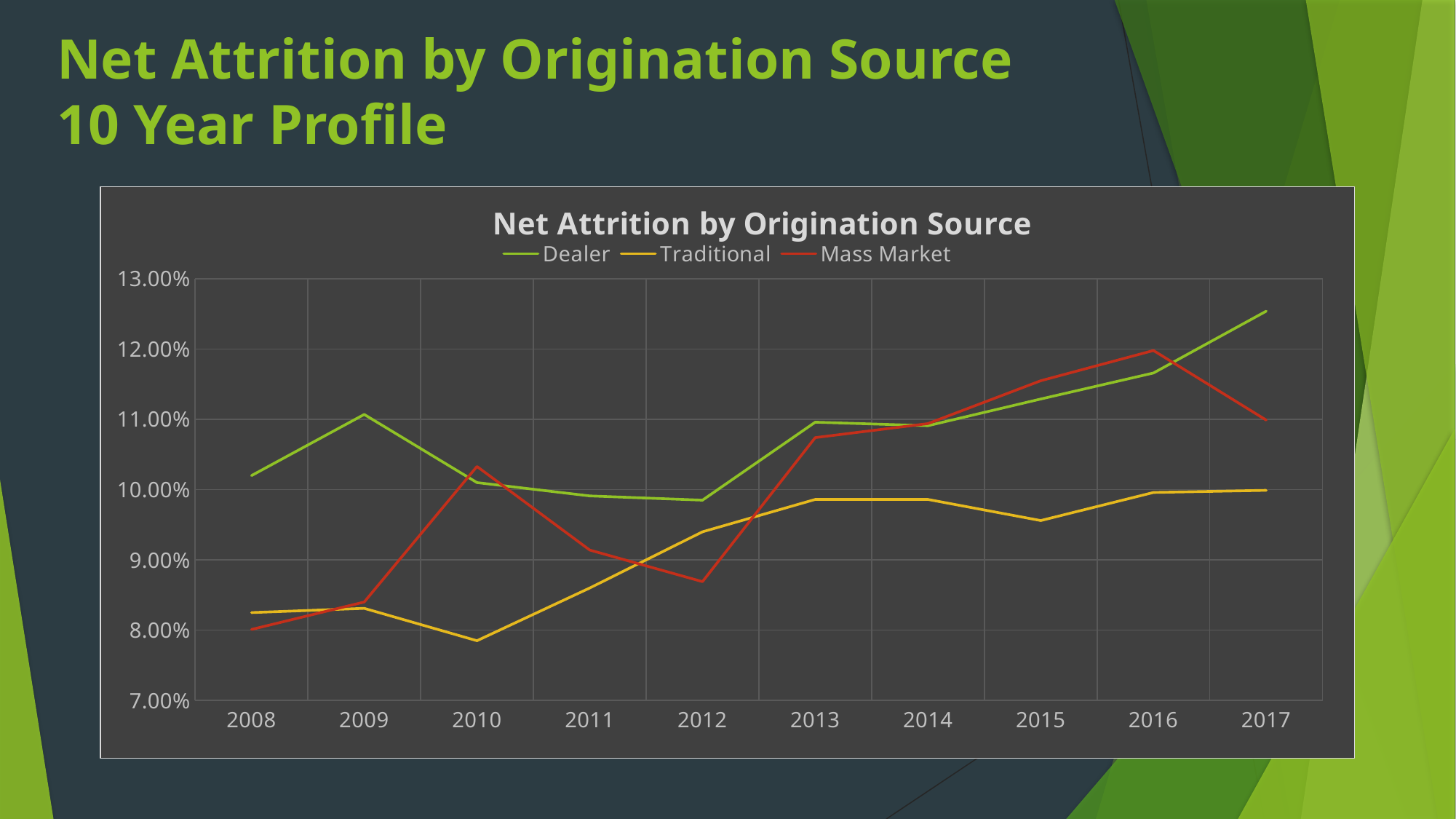
How many years are plotted along the x axis? 10 What kind of chart is shown on the slide? line chart In 2017, which series has the higher value, Dealer or Mass Market? Dealer Is the Dealer value for 2017 greater or less than 12.00%? greater Does the Traditional series rise or fall from 2010 to 2013? rise In which year does the Mass Market series reach its highest value? 2016 In 2012, which series has the higher value, Dealer or Mass Market? Dealer Is the Traditional value for 2010 greater or less than 8.00%? less In which year is the Dealer series at its highest? 2017 Is the Mass Market value for 2012 greater or less than 9.00%? less In which year is the Traditional series at its lowest? 2010 How many series does the legend list? 3